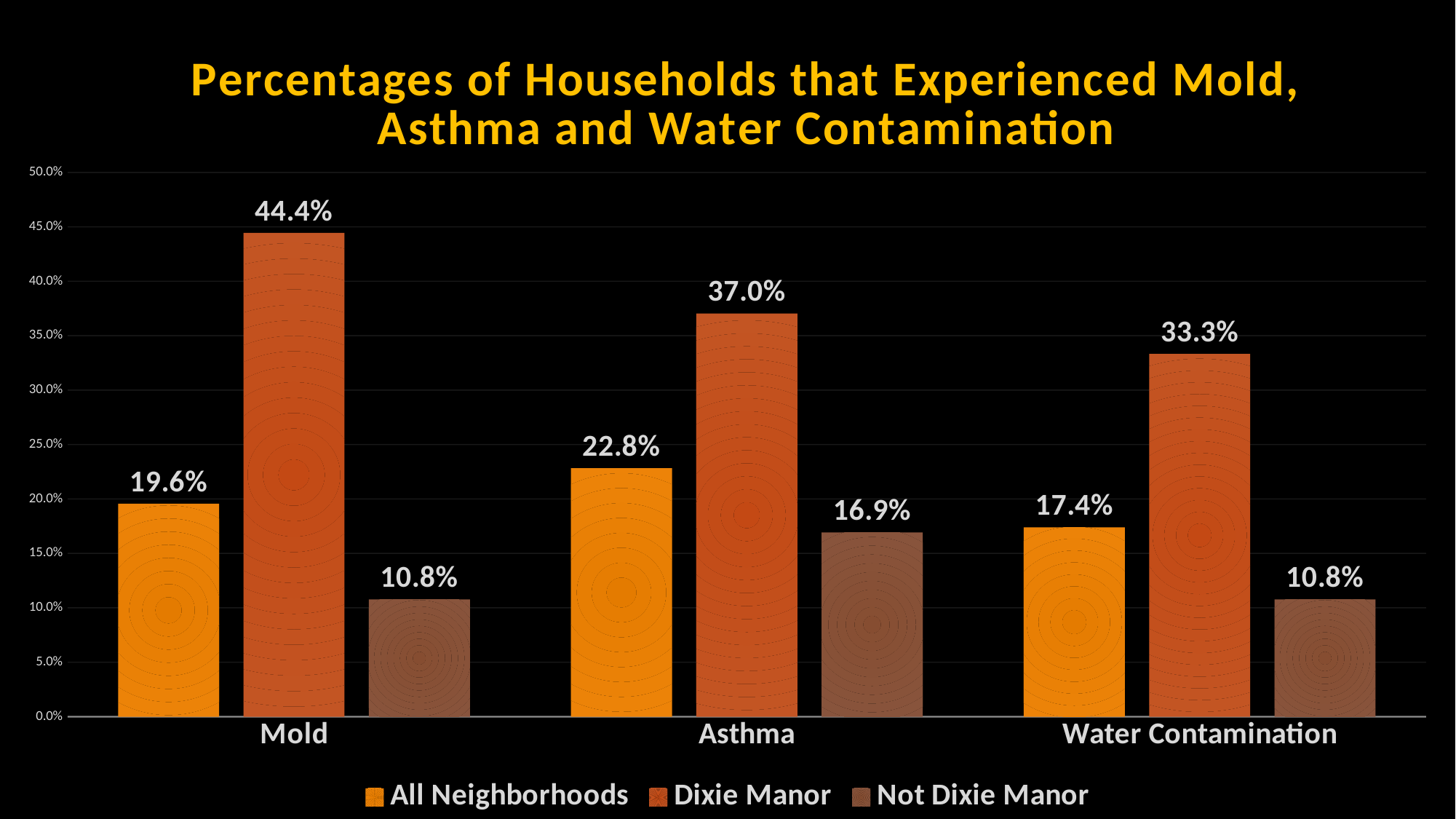
What is the value for All Neighborhoods in the Asthma category? 22.8% Which category has the lowest value for All Neighborhoods? Water Contamination What is the title of the chart? Percentages of Households that Experienced Mold, Asthma and Water Contamination How many categories are shown on the x axis? 3 Which category has the highest value for Dixie Manor? Mold What kind of chart is shown on the slide? Bar chart What percentage of Dixie Manor households experienced mold? 44.4% Which is larger: the All Neighborhoods value for Mold or the Not Dixie Manor value for Asthma? All Neighborhoods value for Mold How many series does the legend list? 3 Is the Dixie Manor value for Water Contamination greater or less than 30.0%? greater What is the difference between the Dixie Manor and Not Dixie Manor values for Asthma? 20.1% What is the value for Not Dixie Manor in the Water Contamination category? 10.8%